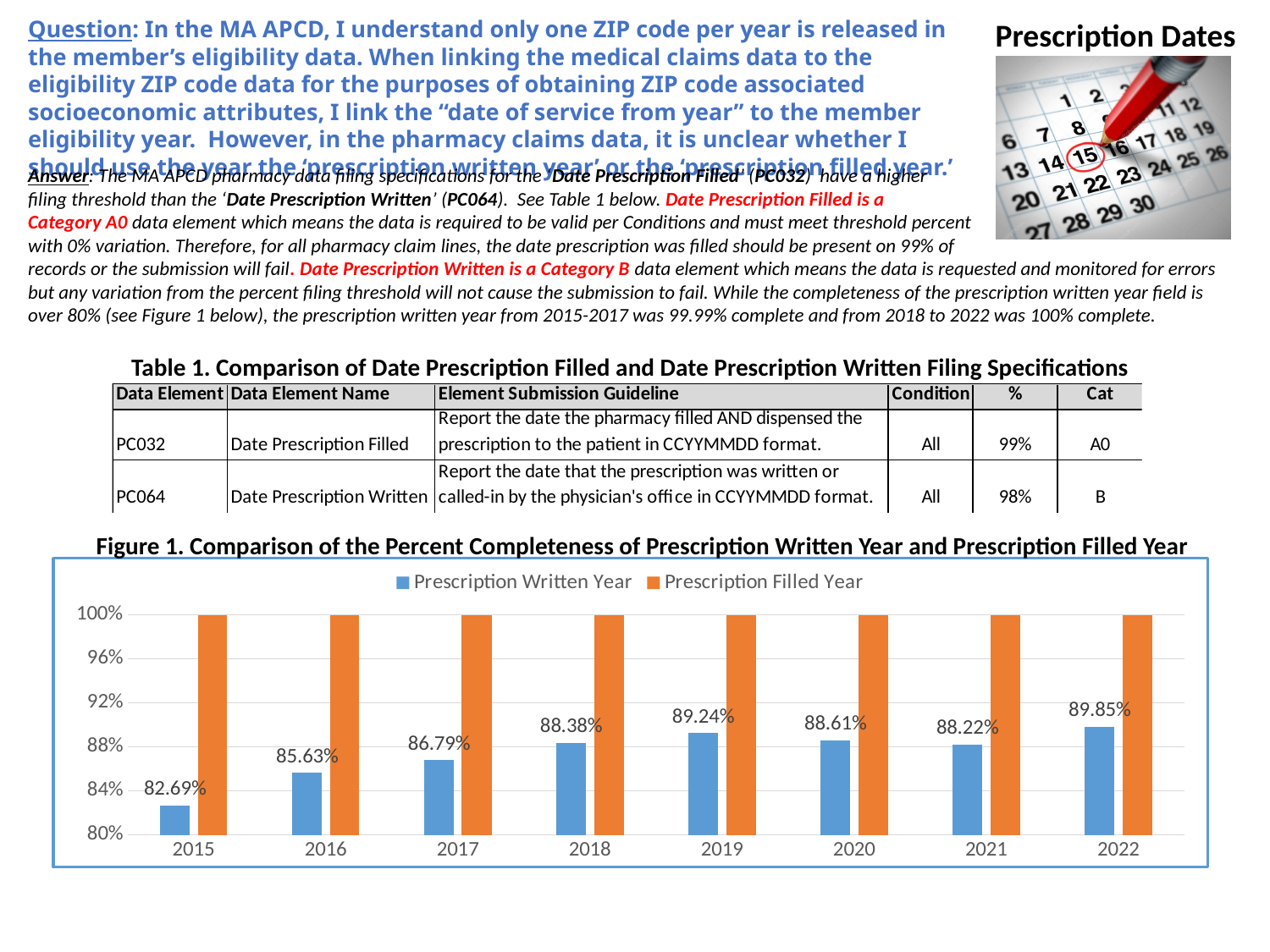
In Figure 1, how many years are shown on the x axis? 8 In Figure 1, what is the Prescription Written Year completeness value for 2019? 89.24% What kind of chart is Figure 1? Bar chart In Figure 1, what is the Prescription Written Year completeness value for 2022? 89.85% In Figure 1, what is the Prescription Written Year completeness value for 2015? 82.69% In Figure 1, is the Prescription Filled Year value for 2018 greater or less than 96%? greater In Figure 1, which year has a higher Prescription Written Year value, 2019 or 2020? 2019 In Figure 1, which year has the lowest Prescription Written Year completeness? 2015 In Figure 1, what is the difference between the Prescription Written Year values for 2022 and 2015? 7.16 percentage points In Figure 1, how many series does the legend list? 2 In Figure 1, which year has the highest Prescription Written Year completeness? 2022 In Figure 1, does the Prescription Written Year value rise or fall from 2015 to 2019? Rise